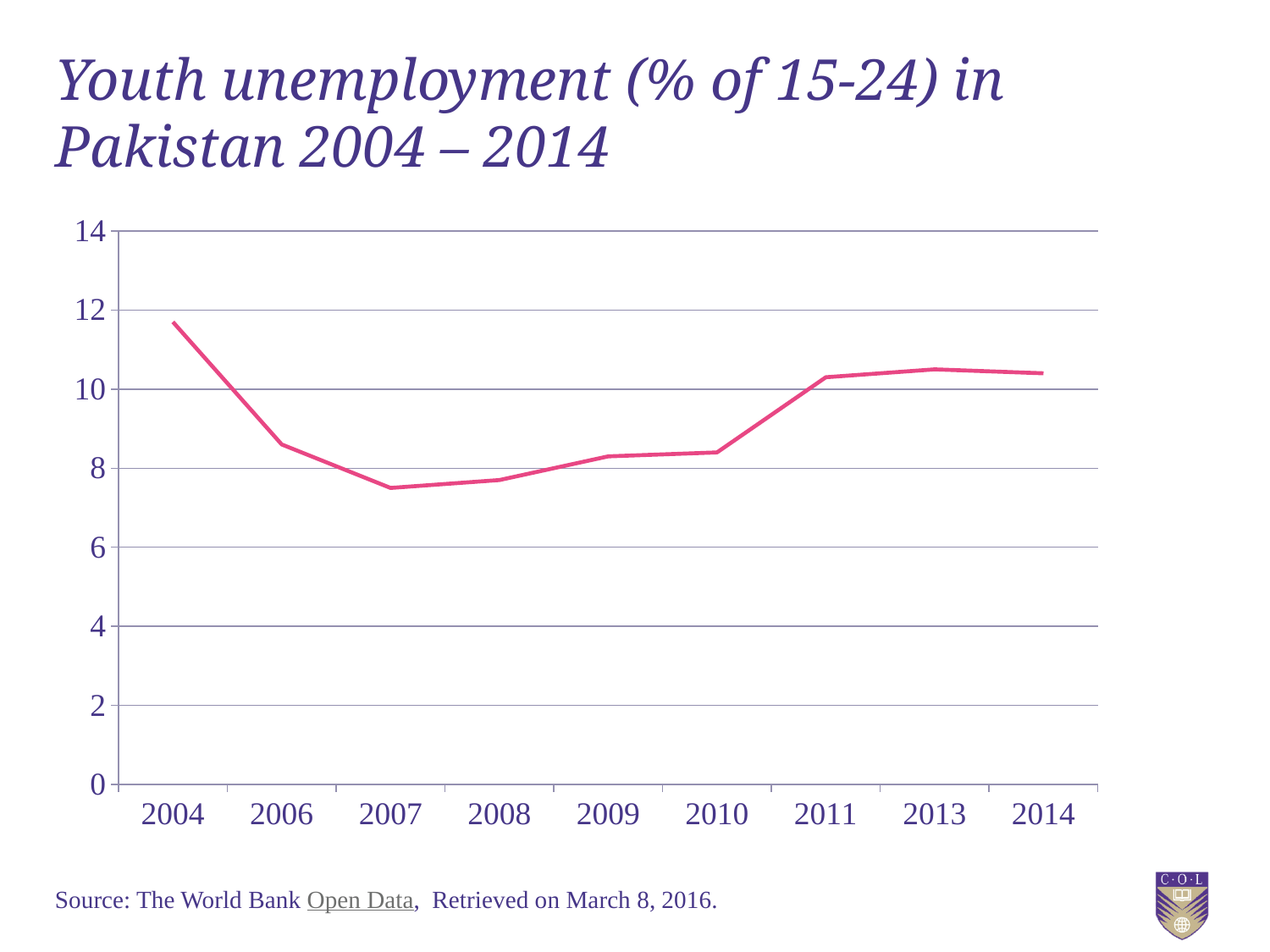
What is the title of the chart? Youth unemployment (% of 15-24) in Pakistan 2004 – 2014 Is the value for 2004 greater or less than 10? greater Which is larger, the value for 2007 or the value for 2011? 2011 Which is larger, the value for 2004 or the value for 2014? 2004 Which year has the highest youth unemployment rate? 2004 Is the value for 2007 greater or less than 8? less How many years are plotted on the x axis? 9 Is the value for 2014 greater or less than 10? greater Does the youth unemployment rate rise or fall from 2004 to 2007? fall What kind of chart is shown on the slide? line chart